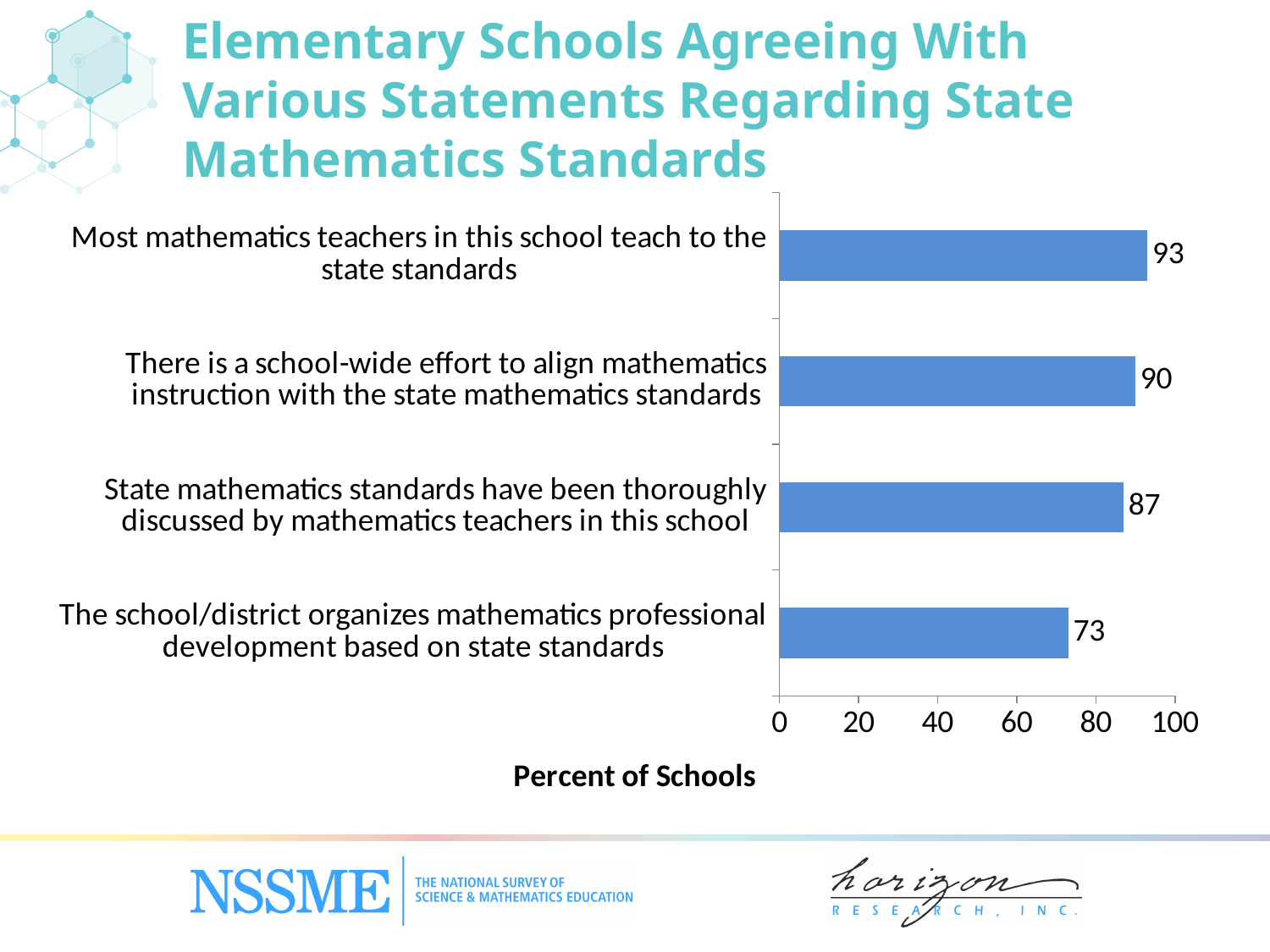
What percent of elementary schools agree that state mathematics standards have been thoroughly discussed by mathematics teachers in this school? 87 Which statement has the lowest percent of schools agreeing? The school/district organizes mathematics professional development based on state standards What is the label of the horizontal axis? Percent of Schools Which statement has the highest percent of schools agreeing? Most mathematics teachers in this school teach to the state standards What percent of elementary schools agree that there is a school-wide effort to align mathematics instruction with the state mathematics standards? 90 What is the difference in percent of schools between the school-wide alignment effort statement and the thoroughly discussed standards statement? 3 What percent of elementary schools agree that most mathematics teachers in this school teach to the state standards? 93 How many statements are shown in the chart? 4 What type of chart is shown on the slide? Bar chart Which has a higher percent of schools agreeing: the school-wide alignment effort statement or the professional development statement? There is a school-wide effort to align mathematics instruction with the state mathematics standards What is the difference in percent of schools between the statement about teachers teaching to the state standards and the statement about professional development based on state standards? 20 What percent of elementary schools agree that the school/district organizes mathematics professional development based on state standards? 73